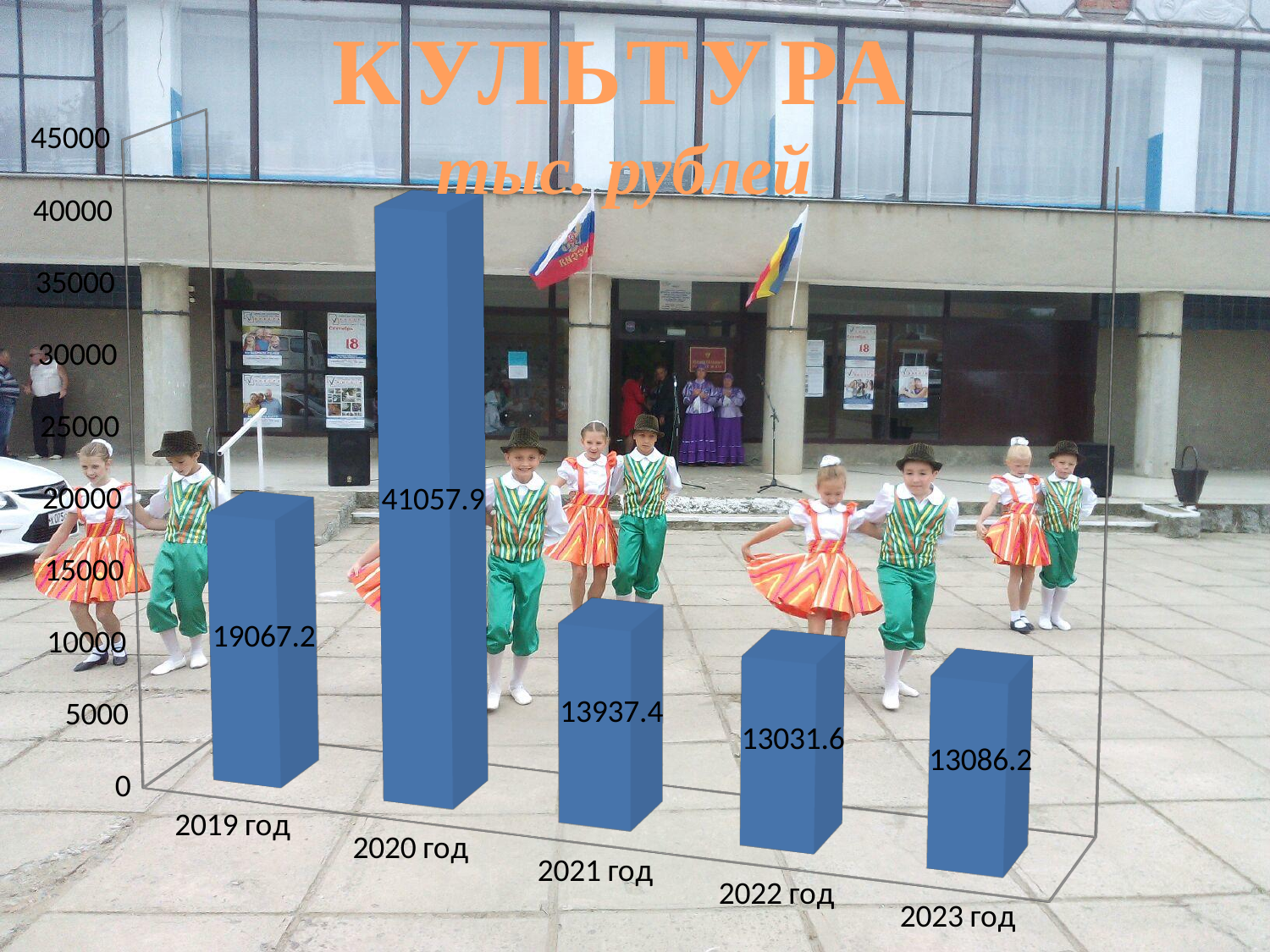
Which year has the highest value? 2020 год Which is larger, the value for 2019 год or the value for 2021 год? 2019 год What kind of chart is shown on the slide? bar chart What unit is given under the chart title КУЛЬТУРА? тыс. рублей What is the value for 2022 год? 13031.6 What is the value for 2020 год? 41057.9 What is the difference between the values for 2021 год and 2022 год? 905.8 What is the difference between the values for 2020 год and 2019 год? 21990.7 What is the value for 2019 год? 19067.2 How many years are shown on the chart? 5 Which year has the lowest value? 2022 год What is the value for 2023 год? 13086.2